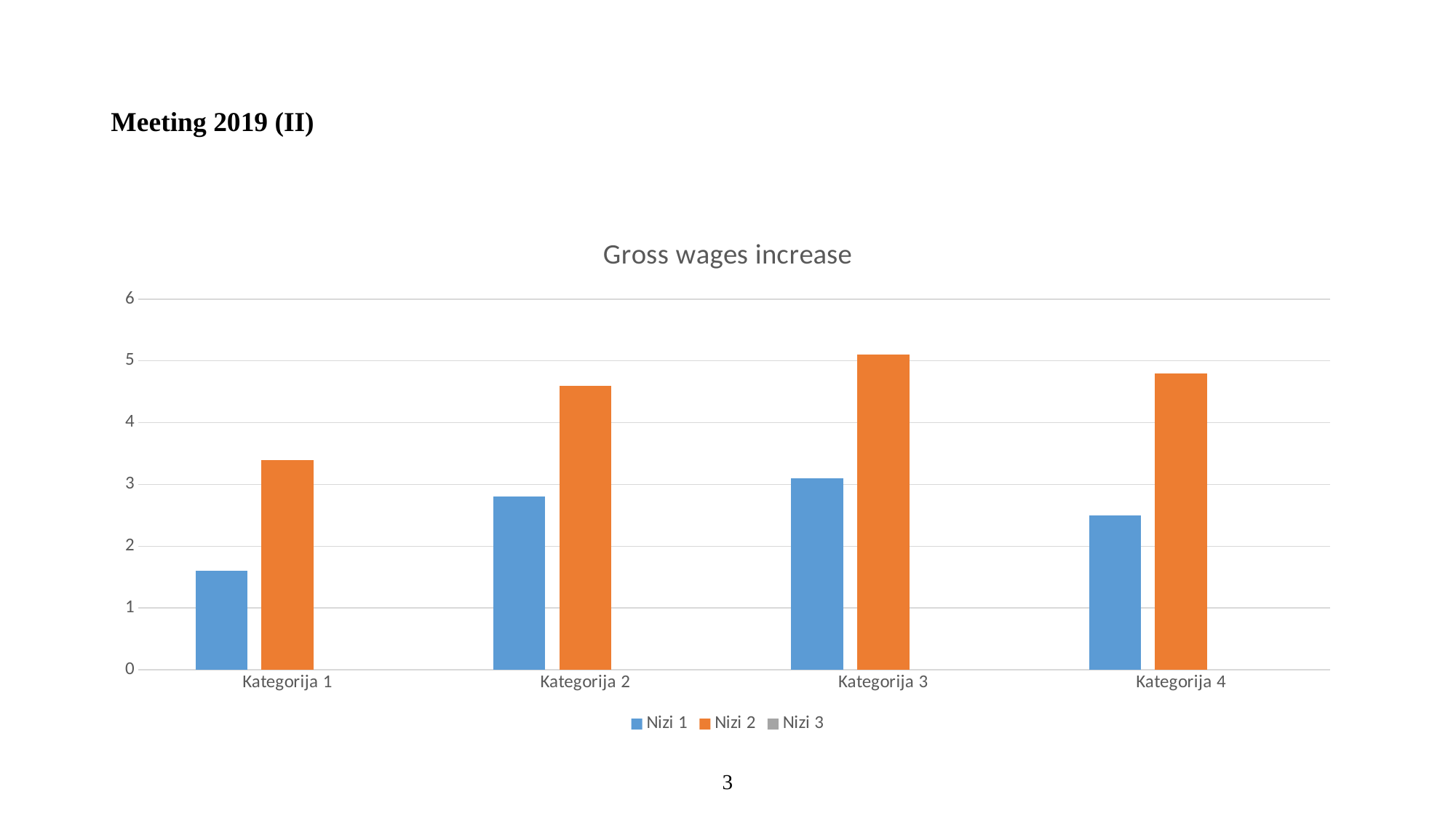
In Kategorija 1, which series has the larger value, Nizi 1 or Nizi 2? Nizi 2 Which category has the highest value for Nizi 1? Kategorija 3 Which category has the highest value for Nizi 2? Kategorija 3 How many categories are shown on the x axis? 4 Which category has the lowest value for Nizi 2? Kategorija 1 What kind of chart is shown on the slide? bar chart Is the value for Nizi 1 in Kategorija 1 greater or less than 2? less Which category has the lowest value for Nizi 1? Kategorija 1 Is the value for Nizi 2 in Kategorija 1 greater or less than 4? less How many series does the legend list? 3 What is the title of the chart? Gross wages increase